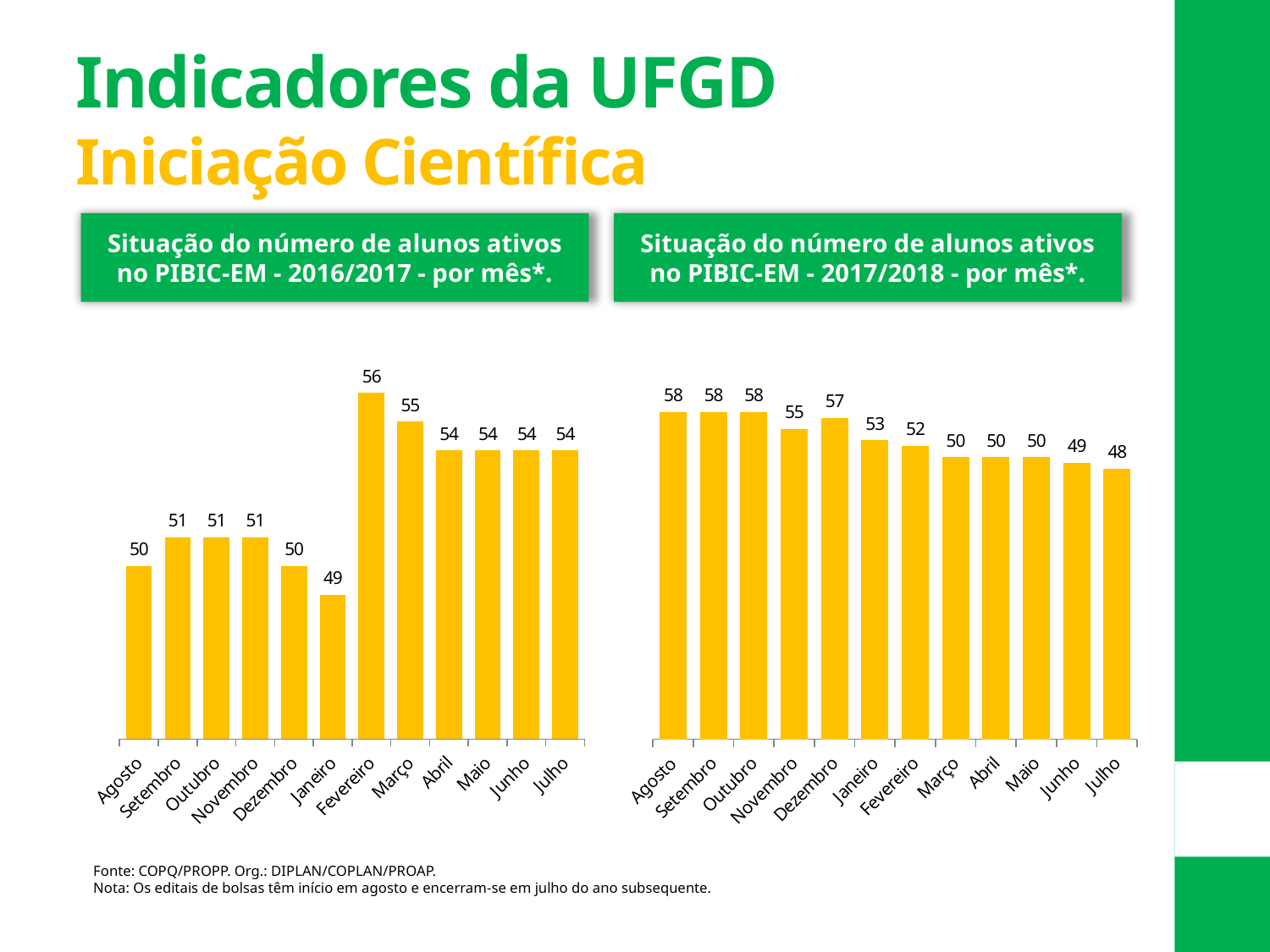
In the 2017/2018 chart (right), which is larger, the value for Dezembro or the value for Novembro? Dezembro In the 2017/2018 chart (right), which month has the lowest value? Julho In the 2017/2018 chart (right), what is the value for Dezembro? 57 In the 2017/2018 chart (right), do the values generally rise or fall from Agosto to Julho? fall What kind of chart is the 2017/2018 chart (right)? bar chart In the 2016/2017 chart (left), what is the difference between the value for Fevereiro and the value for Janeiro? 7 In the 2016/2017 chart (left), which month has the lowest value? Janeiro In the 2017/2018 chart (right), what is the value for Julho? 48 In the 2017/2018 chart (right), what is the difference between the value for Agosto and the value for Julho? 10 In the 2016/2017 chart (left), which month has the highest value? Fevereiro In the 2016/2017 chart (left), what is the value for Fevereiro? 56 How many months are plotted in the 2016/2017 chart (left)? 12